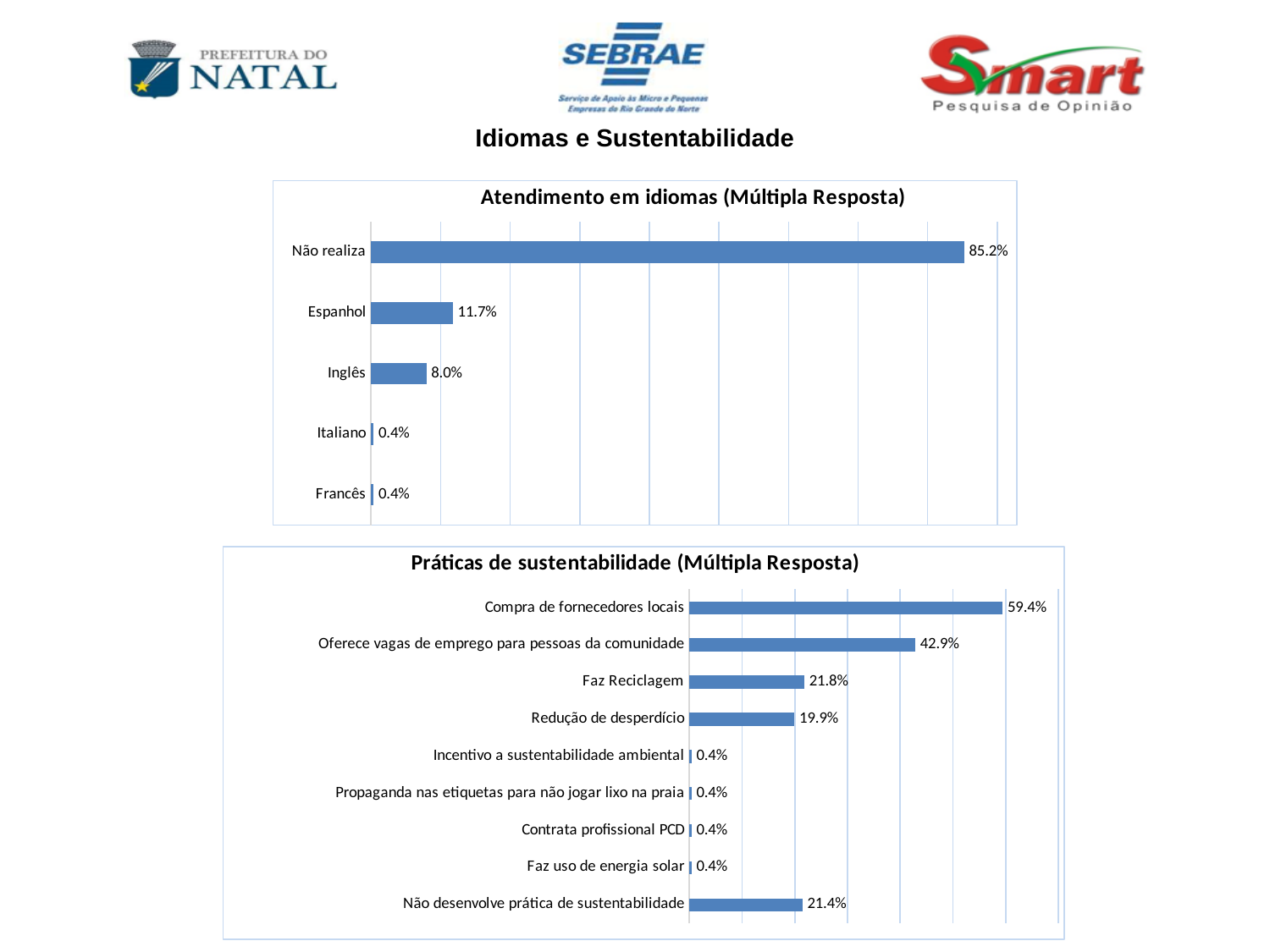
In the 'Atendimento em idiomas (Múltipla Resposta)' chart, what is the value for Não realiza? 85.2% In the 'Atendimento em idiomas (Múltipla Resposta)' chart, which category has the highest value? Não realiza In the 'Práticas de sustentabilidade (Múltipla Resposta)' chart, what is the difference between Compra de fornecedores locais and Oferece vagas de emprego para pessoas da comunidade? 16.5% In the 'Práticas de sustentabilidade (Múltipla Resposta)' chart, what is the value for Não desenvolve prática de sustentabilidade? 21.4% In the 'Atendimento em idiomas (Múltipla Resposta)' chart, what is the value for Espanhol? 11.7% What kind of chart is 'Atendimento em idiomas (Múltipla Resposta)'? Bar chart In the 'Atendimento em idiomas (Múltipla Resposta)' chart, how many categories are shown? 5 In the 'Práticas de sustentabilidade (Múltipla Resposta)' chart, which is larger: Faz Reciclagem or Redução de desperdício? Faz Reciclagem In the 'Práticas de sustentabilidade (Múltipla Resposta)' chart, what is the value for Compra de fornecedores locais? 59.4% In the 'Práticas de sustentabilidade (Múltipla Resposta)' chart, what is the value for Faz Reciclagem? 21.8% In the 'Práticas de sustentabilidade (Múltipla Resposta)' chart, how many categories are shown? 9 In the 'Atendimento em idiomas (Múltipla Resposta)' chart, what is the difference between Espanhol and Inglês? 3.7%